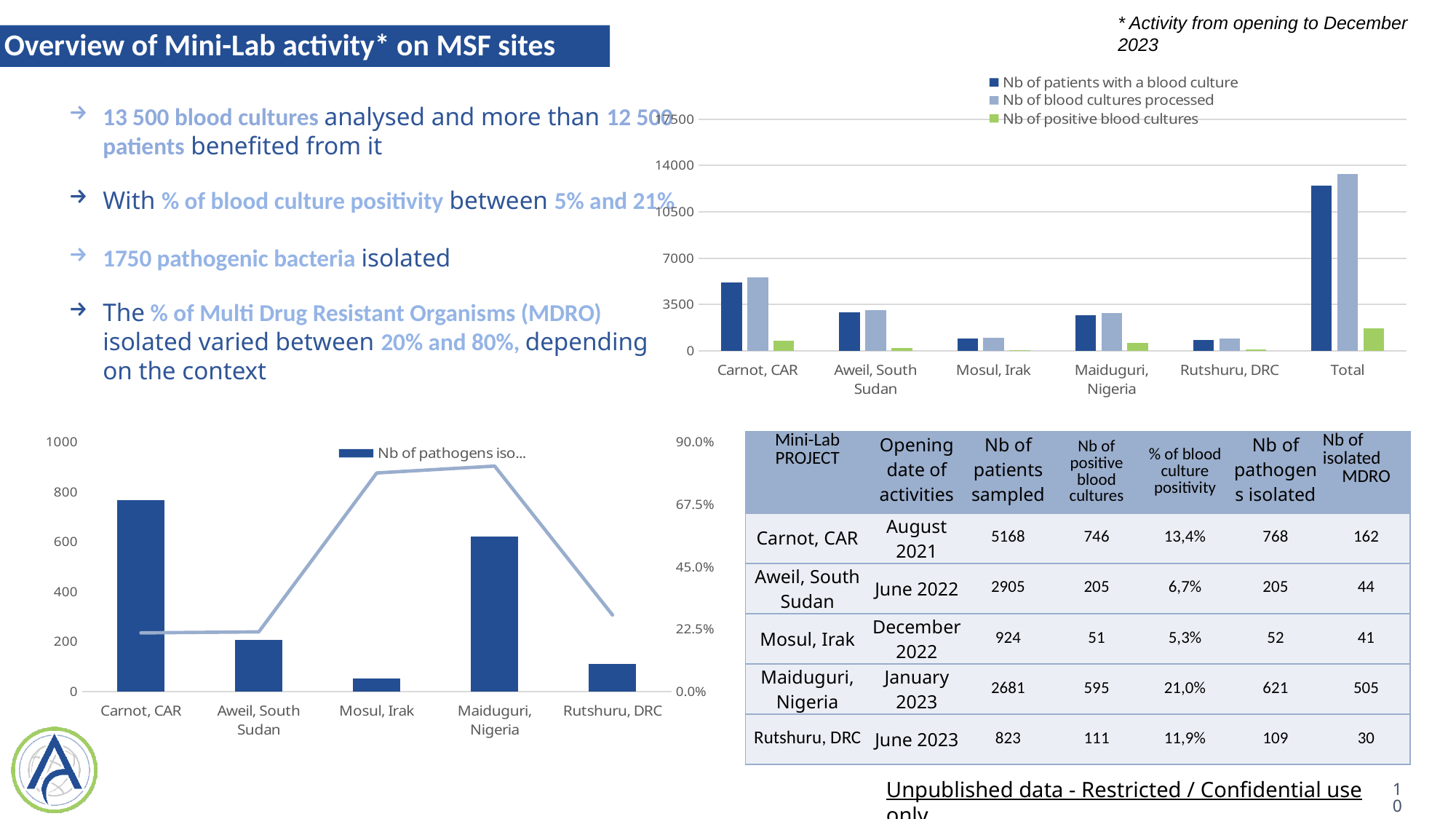
In the top-right chart, which has more patients with a blood culture: Carnot, CAR or Aweil, South Sudan? Carnot, CAR In the bottom-left chart, which site has the highest number of pathogens isolated? Carnot, CAR In the top-right chart, which site (excluding Total) has the highest number of patients with a blood culture? Carnot, CAR In the top-right chart, how many series does the legend list? 3 In the bottom-left chart, which site has the lowest number of pathogens isolated? Mosul, Irak In the bottom-left chart, is the number of pathogens isolated for Rutshuru, DRC greater or less than 200? less In the top-right chart, is the number of patients with a blood culture for Carnot, CAR greater or less than 3500? greater In the top-right chart, is the number of blood cultures processed for Mosul, Irak greater or less than 3500? less In the top-right chart, how many categories are shown on the x axis? 6 What kind of chart is the top-right chart? bar chart In the bottom-left chart, how many sites are shown on the x axis? 5